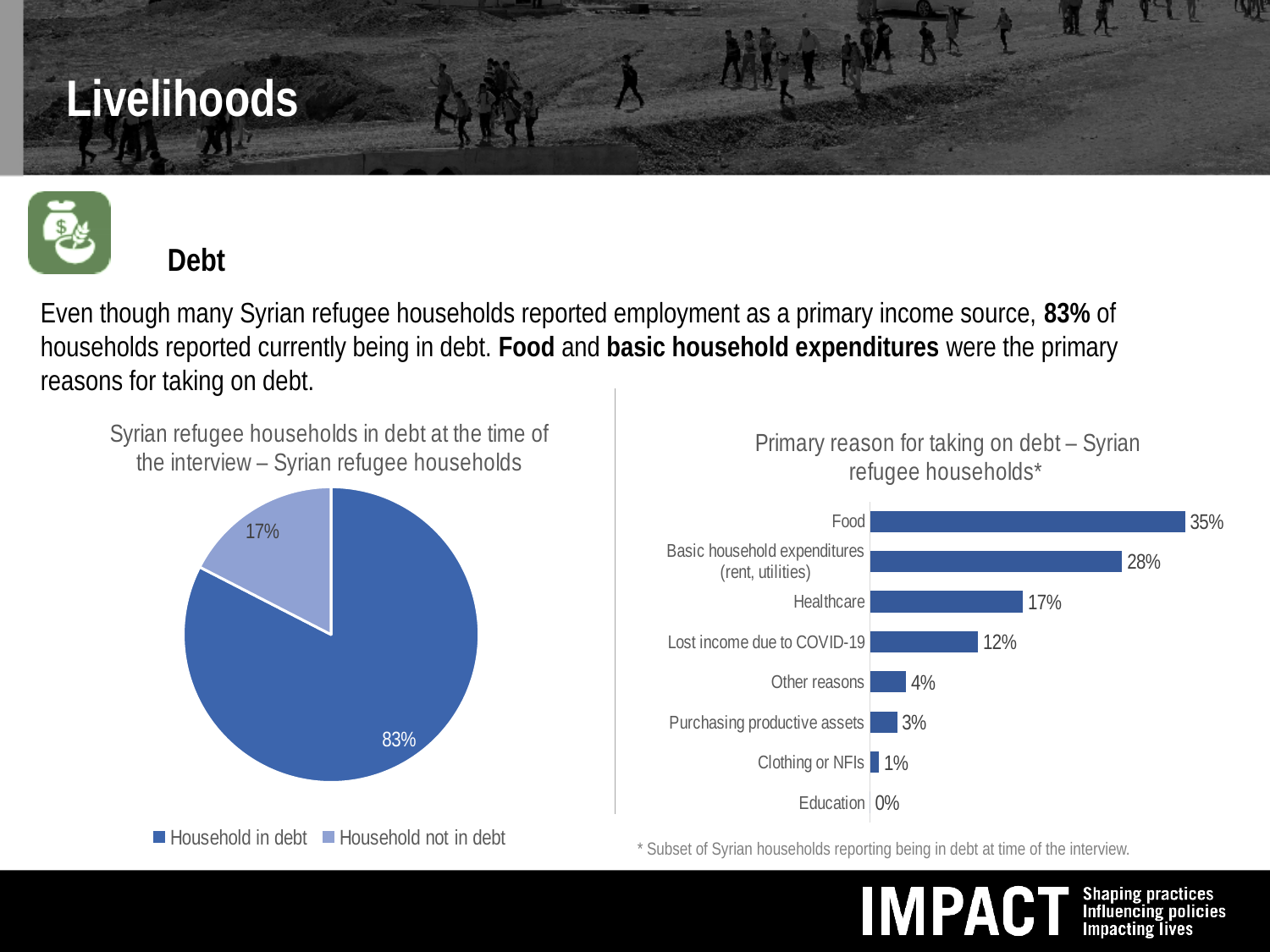
How many reasons are listed in the 'Primary reason for taking on debt' chart? 8 In the 'Primary reason for taking on debt' chart, what is the value for Healthcare? 17% What kind of chart is the chart on the left? Pie chart In the pie chart on the left, what share of Syrian refugee households were in debt at the time of the interview? 83% In the 'Primary reason for taking on debt' chart, which is larger: Other reasons or Purchasing productive assets? Other reasons What kind of chart is the 'Primary reason for taking on debt' chart on the right? Bar chart In the 'Primary reason for taking on debt' chart, what is the value for Lost income due to COVID-19? 12% In the 'Primary reason for taking on debt' chart, which reason has the highest value? Food In the 'Primary reason for taking on debt' chart, what is the difference between Food and Basic household expenditures (rent, utilities)? 7% In the pie chart on the left, what share of households were not in debt? 17% In the 'Primary reason for taking on debt' chart, which reason has the lowest value? Education How many entries does the legend of the pie chart on the left list? 2